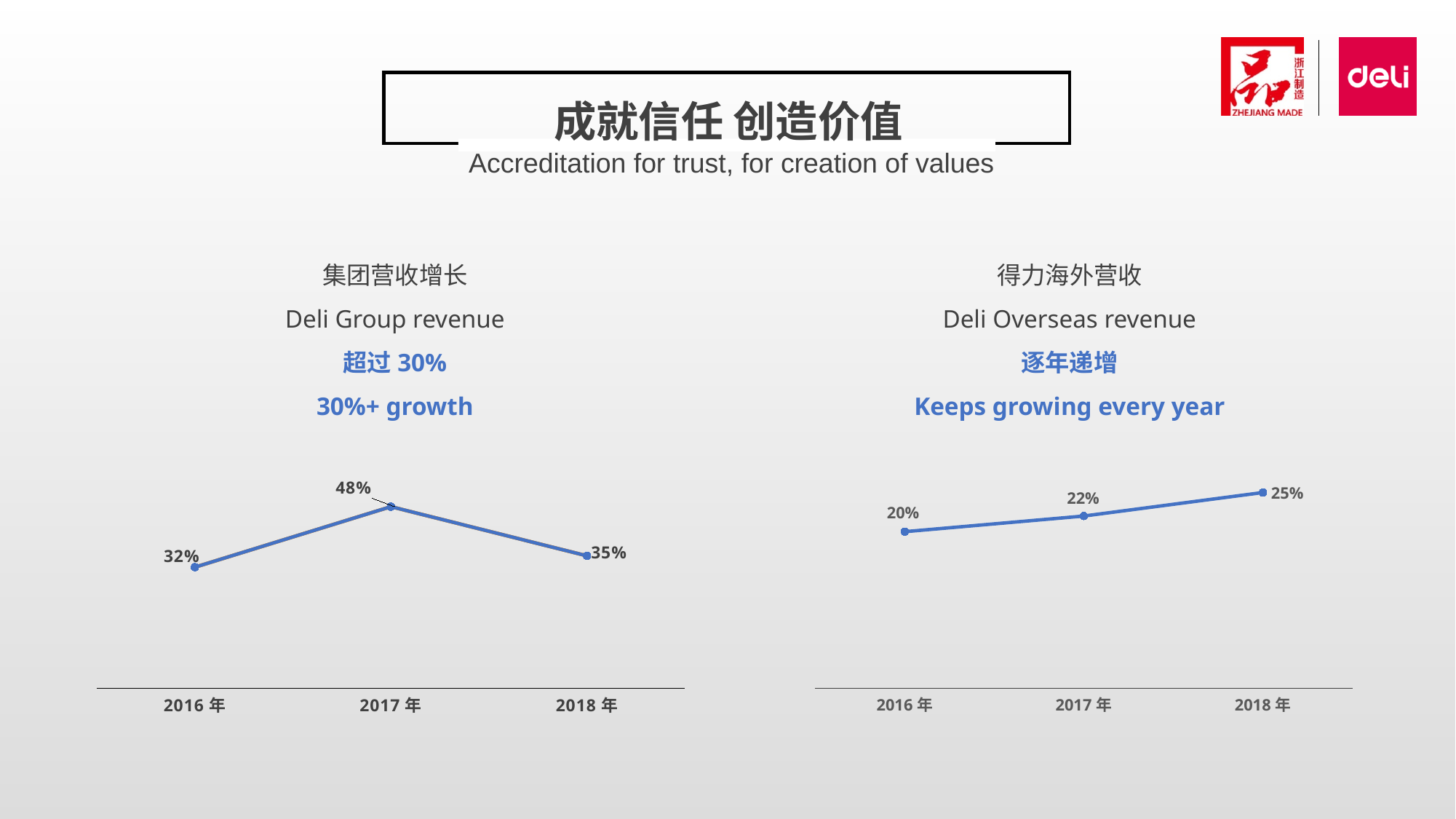
In the Deli Overseas revenue chart on the right, what is the difference between the 2018 and 2016 values? 5% In the Deli Group revenue chart on the left, which year has the lowest value? 2016 In the Deli Group revenue chart on the left, what is the value for 2017? 48% In the Deli Group revenue chart on the left, what is the value for 2016? 32% In the Deli Group revenue chart on the left, what is the difference between the 2017 and 2018 values? 13% In the Deli Overseas revenue chart on the right, do the values rise or fall from 2016 to 2018? rise In the Deli Overseas revenue chart on the right, what is the value for 2016? 20% In the Deli Overseas revenue chart on the right, what is the value for 2018? 25% What kind of chart is the Deli Overseas revenue chart on the right? line chart In the Deli Overseas revenue chart on the right, which year has the highest value? 2018 In the Deli Group revenue chart on the left, which year has the highest value? 2017 How many data points are plotted in the Deli Group revenue chart on the left? 3